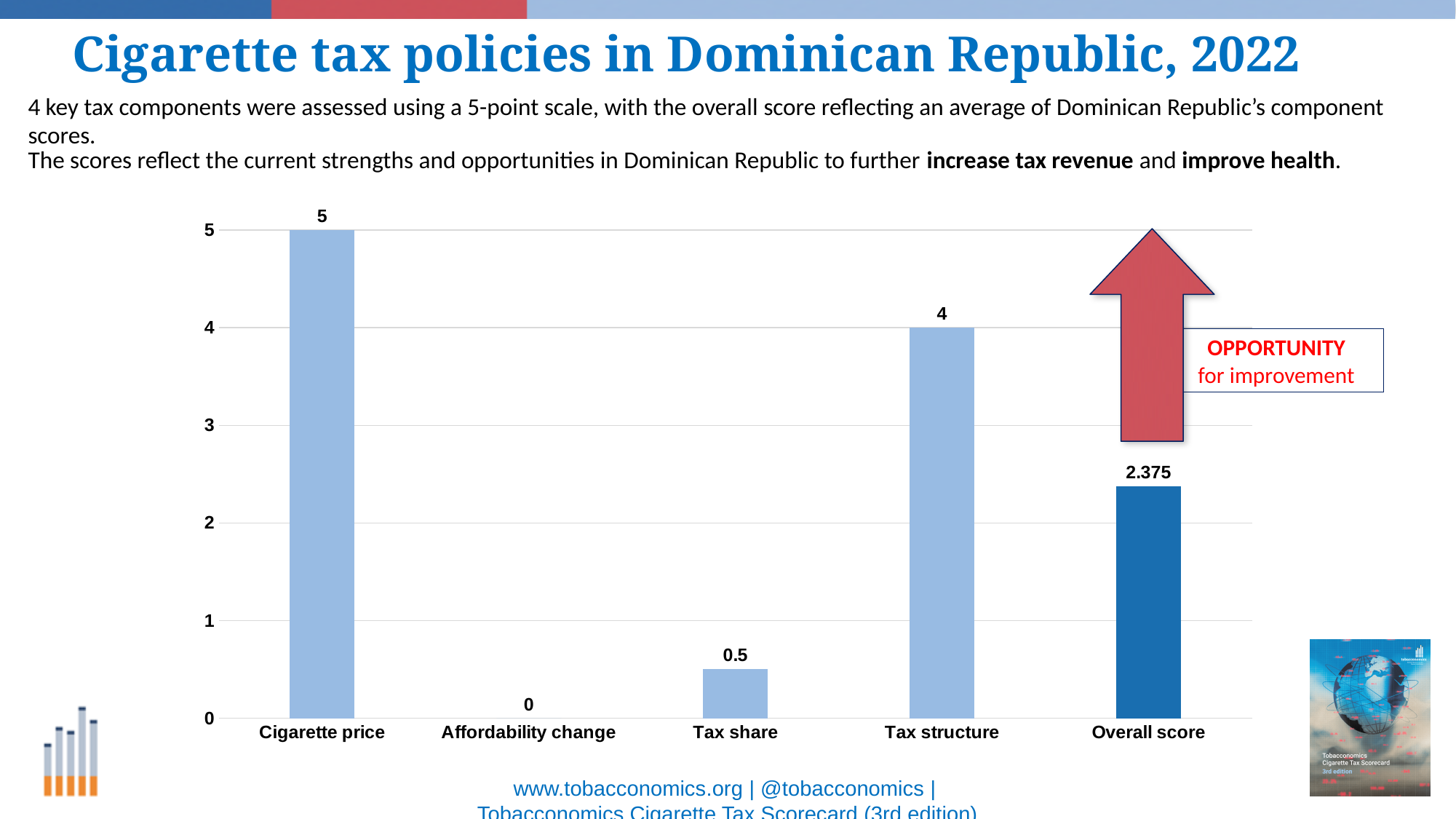
Which bar is drawn in a darker blue than the others? Overall score Which category has the highest value? Cigarette price Which category has the lowest value? Affordability change Is the value for Tax structure greater or less than 3? greater What kind of chart is shown on the slide? bar chart What is the value for Tax share? 0.5 How many categories are shown on the x axis? 5 What is the value for Overall score? 2.375 What is the difference between the values for Cigarette price and Tax structure? 1 What is the value for Affordability change? 0 Which is larger, the value for Tax share or the value for Overall score? Overall score What is the value for Cigarette price? 5